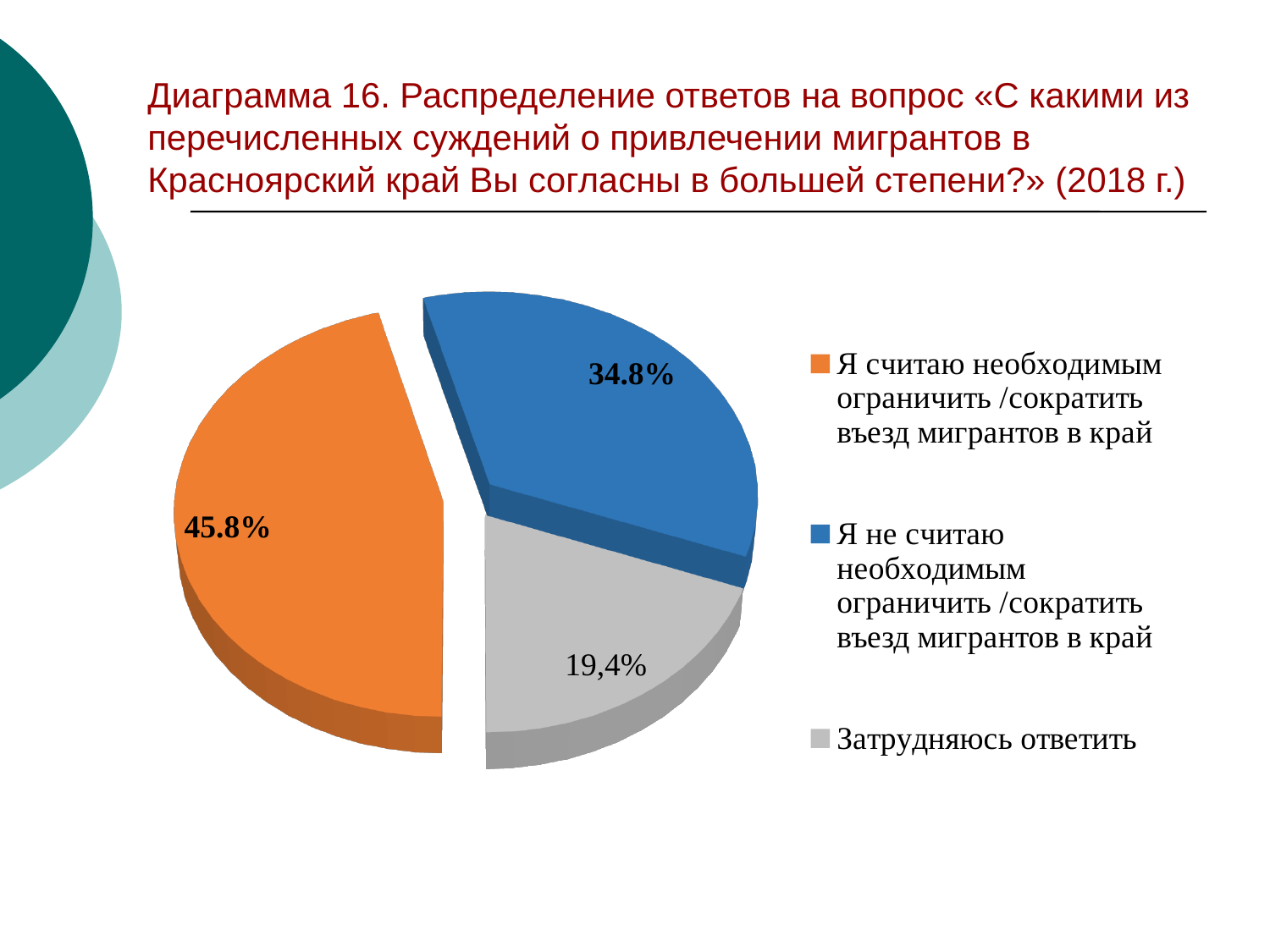
What kind of chart is shown on the slide? Pie chart By how many percentage points does the share for «Я считаю необходимым ограничить /сократить въезд мигрантов в край» exceed the share for «Я не считаю необходимым ограничить /сократить въезд мигрантов в край»? 11.0% Which is larger: the share for «Я не считаю необходимым ограничить /сократить въезд мигрантов в край» or the share for «Затрудняюсь ответить»? Я не считаю необходимым ограничить /сократить въезд мигрантов в край What year is given in the chart title? 2018 What share of respondents answered «Затрудняюсь ответить»? 19,4% Which answer option has the smallest slice of the pie? Затрудняюсь ответить What share of respondents chose «Я считаю необходимым ограничить /сократить въезд мигрантов в край»? 45.8% Which answer option has the largest slice of the pie? Я считаю необходимым ограничить /сократить въезд мигрантов в край How many answer options (slices) does the pie chart show? 3 What colour is the slice for «Затрудняюсь ответить»? Grey What is the difference between the share for «Я не считаю необходимым ограничить /сократить въезд мигрантов в край» and the share for «Затрудняюсь ответить»? 15.4% What share of respondents chose «Я не считаю необходимым ограничить /сократить въезд мигрантов в край»? 34.8%